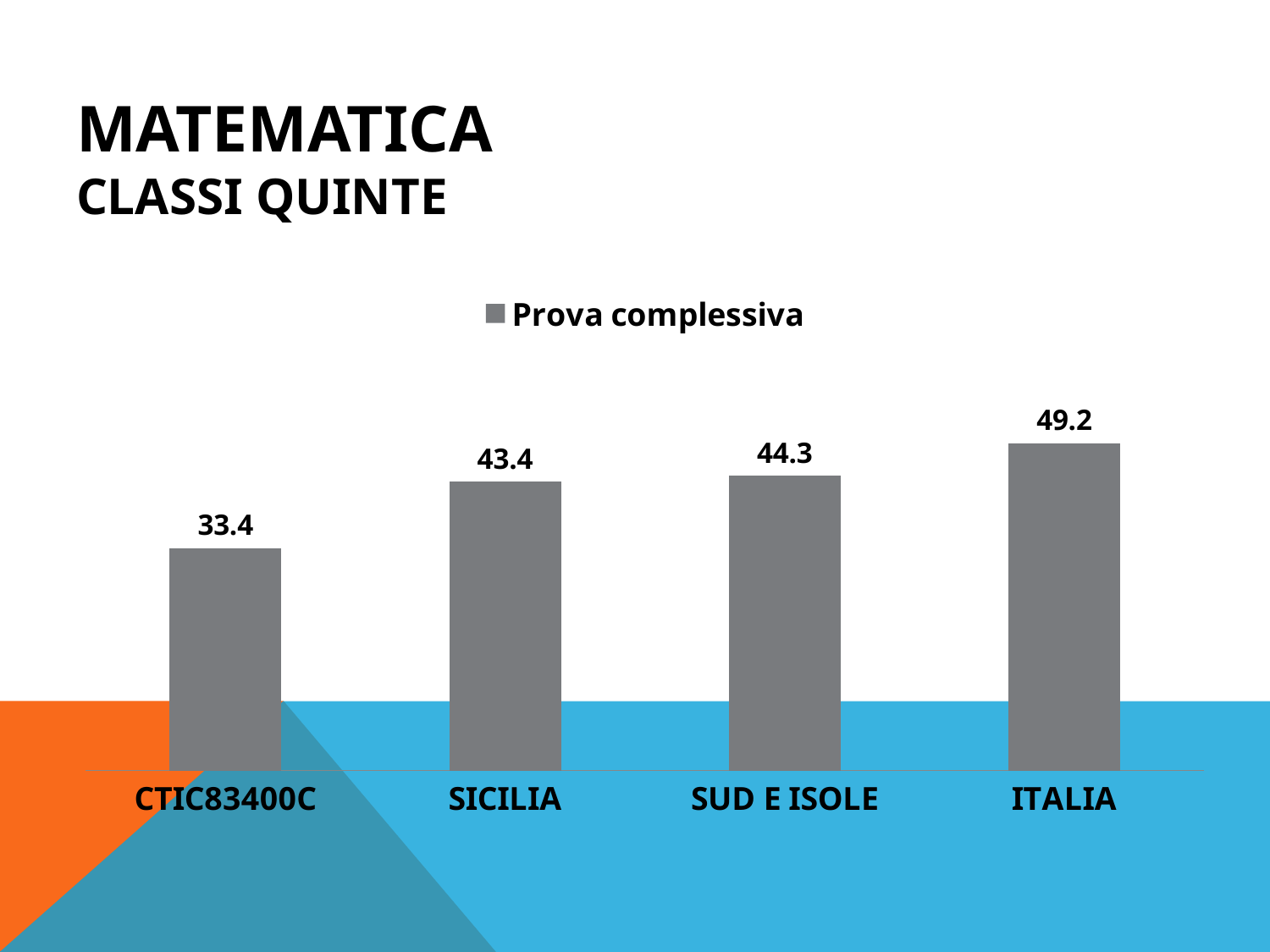
Which category has the lowest value? CTIC83400C What is the difference between the values for ITALIA and CTIC83400C? 15.8 What is the difference between the values for SUD E ISOLE and SICILIA? 0.9 How many categories are shown on the x axis? 4 How many series does the legend list? 1 What is the value for SICILIA? 43.4 What is the value for CTIC83400C? 33.4 What is the value for SUD E ISOLE? 44.3 Which is larger, the value for SICILIA or the value for ITALIA? ITALIA What is the value for ITALIA? 49.2 What kind of chart is shown? bar chart Which category has the highest value? ITALIA